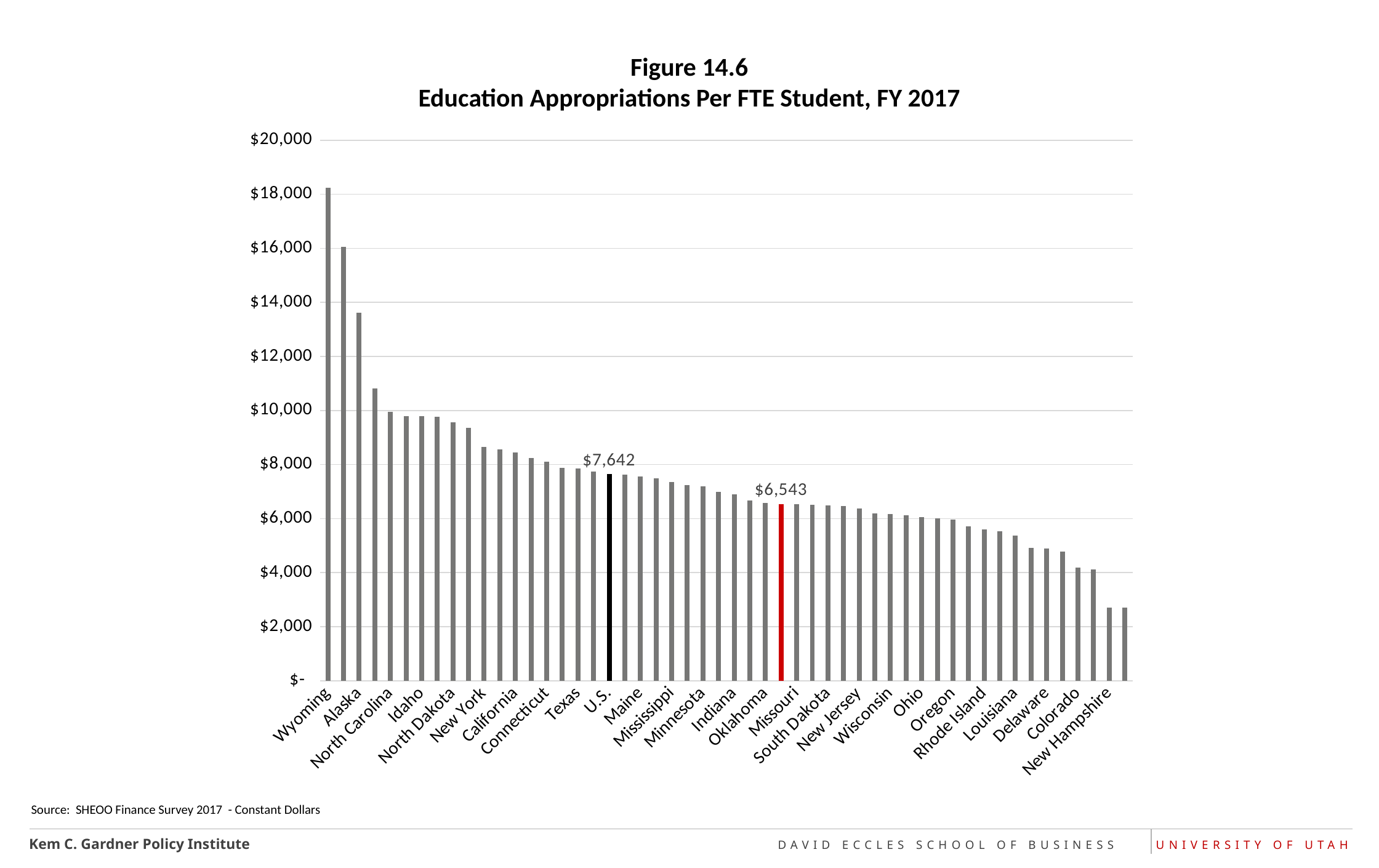
What kind of chart is shown on the slide? bar chart What is the difference between the U.S. value and the value labeled on the red bar? $1,099 Which state has the highest education appropriation per FTE student? Wyoming Which is larger, the value for Texas or the value for Missouri? Texas What is the title of the chart? Figure 14.6 Education Appropriations Per FTE Student, FY 2017 What value is printed above the red highlighted bar? $6,543 Is the value for Wyoming greater or less than $16,000? greater What is the education appropriation per FTE student for the U.S.? $7,642 Do the values generally rise or fall moving from left to right along the x axis? fall Is the value for Delaware greater or less than $6,000? less Is the value for New Hampshire greater or less than $4,000? less